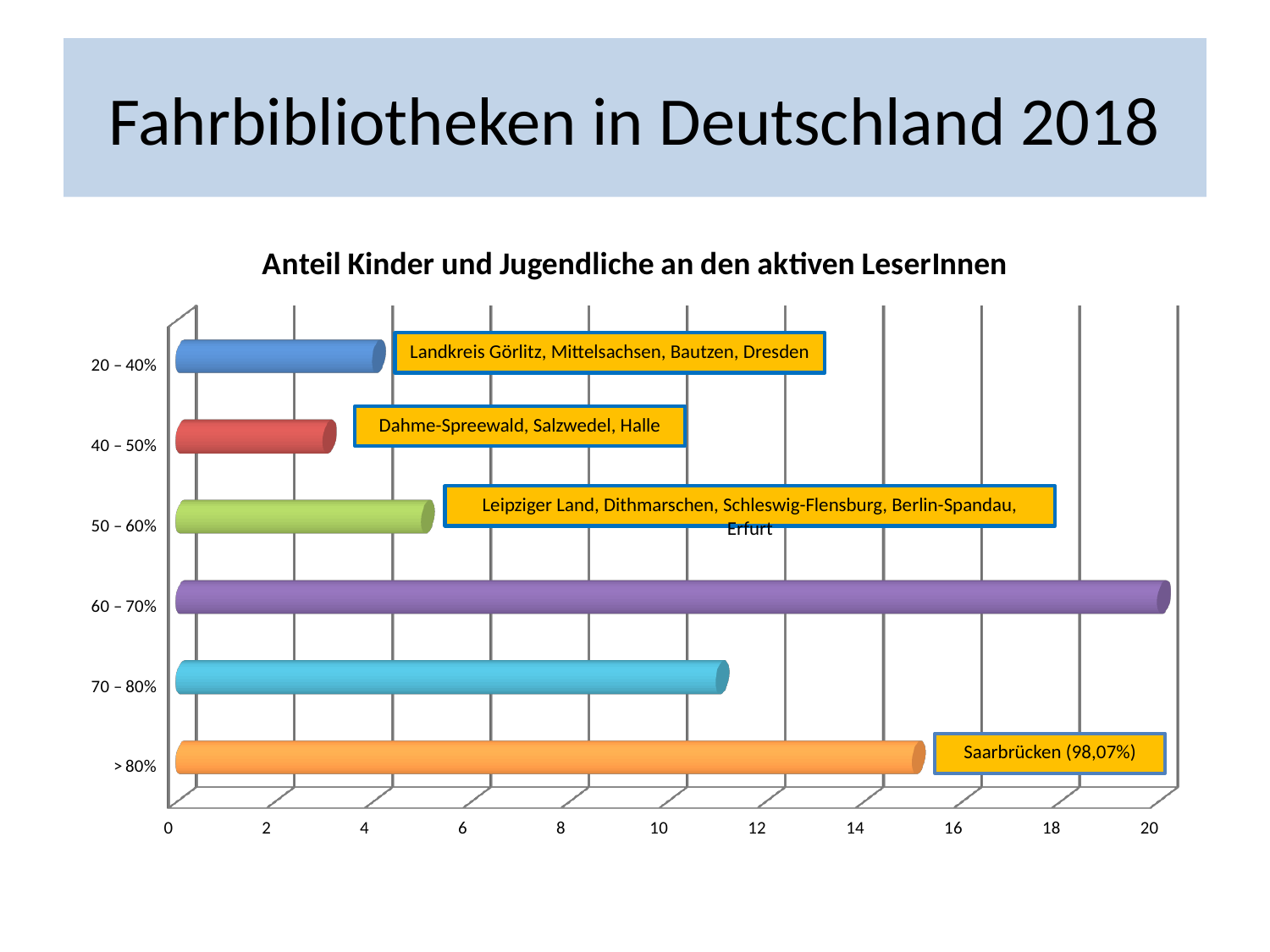
Which library is named in the annotation next to the > 80% bar? Saarbrücken (98,07%) Which category has the highest value? 60 – 70% Is the value for 20 – 40% greater or less than 6? less Is the value for > 80% greater or less than 14? greater Is the value for 70 – 80% greater or less than 10? greater What is the title of the chart? Anteil Kinder und Jugendliche an den aktiven LeserInnen What kind of chart is shown on the slide? bar chart Which category has the lowest value? 40 – 50% How many categories are shown on the chart's vertical axis? 6 Which has the larger value, 70 – 80% or > 80%? > 80%